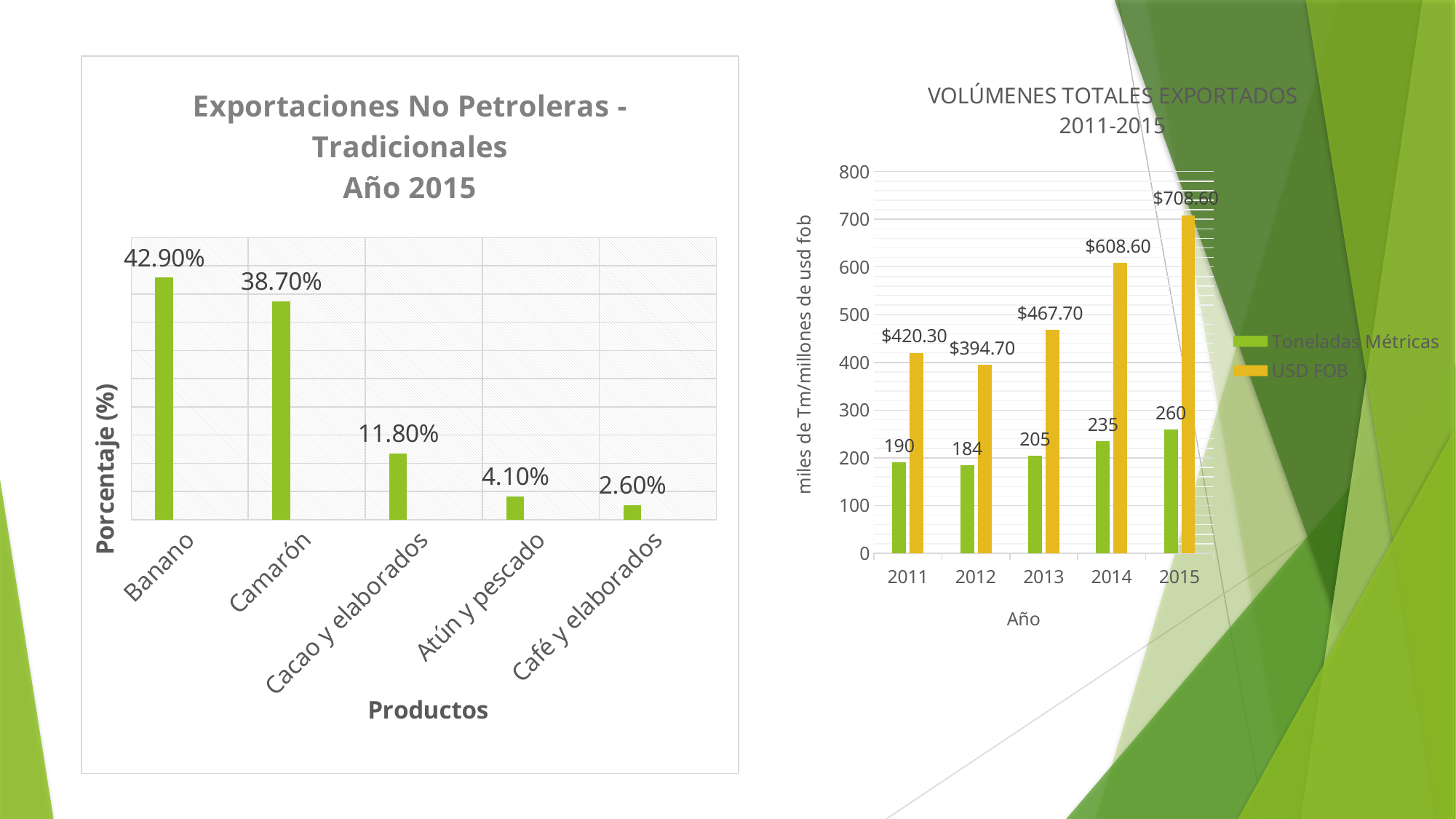
In the 'Exportaciones No Petroleras - Tradicionales Año 2015' chart, what is the value for Banano? 42.90% What kind of chart is the 'VOLÚMENES TOTALES EXPORTADOS 2011-2015' chart? Bar chart In the 'VOLÚMENES TOTALES EXPORTADOS 2011-2015' chart, how many series does the legend list? 2 In the 'VOLÚMENES TOTALES EXPORTADOS 2011-2015' chart, what is the Toneladas Métricas value for 2012? 184 In the 'Exportaciones No Petroleras - Tradicionales Año 2015' chart, how many products are shown? 5 In the 'VOLÚMENES TOTALES EXPORTADOS 2011-2015' chart, which year has the lowest Toneladas Métricas value? 2012 In the 'VOLÚMENES TOTALES EXPORTADOS 2011-2015' chart, what is the difference in Toneladas Métricas between 2015 and 2014? 25 In the 'VOLÚMENES TOTALES EXPORTADOS 2011-2015' chart, what is the USD FOB value for 2014? $608.60 In the 'Exportaciones No Petroleras - Tradicionales Año 2015' chart, what is the value for Cacao y elaborados? 11.80% In the 'Exportaciones No Petroleras - Tradicionales Año 2015' chart, which product has the lowest percentage? Café y elaborados In the 'VOLÚMENES TOTALES EXPORTADOS 2011-2015' chart, which year has the highest USD FOB value? 2015 In the 'Exportaciones No Petroleras - Tradicionales Año 2015' chart, what is the difference between Banano and Camarón? 4.20%